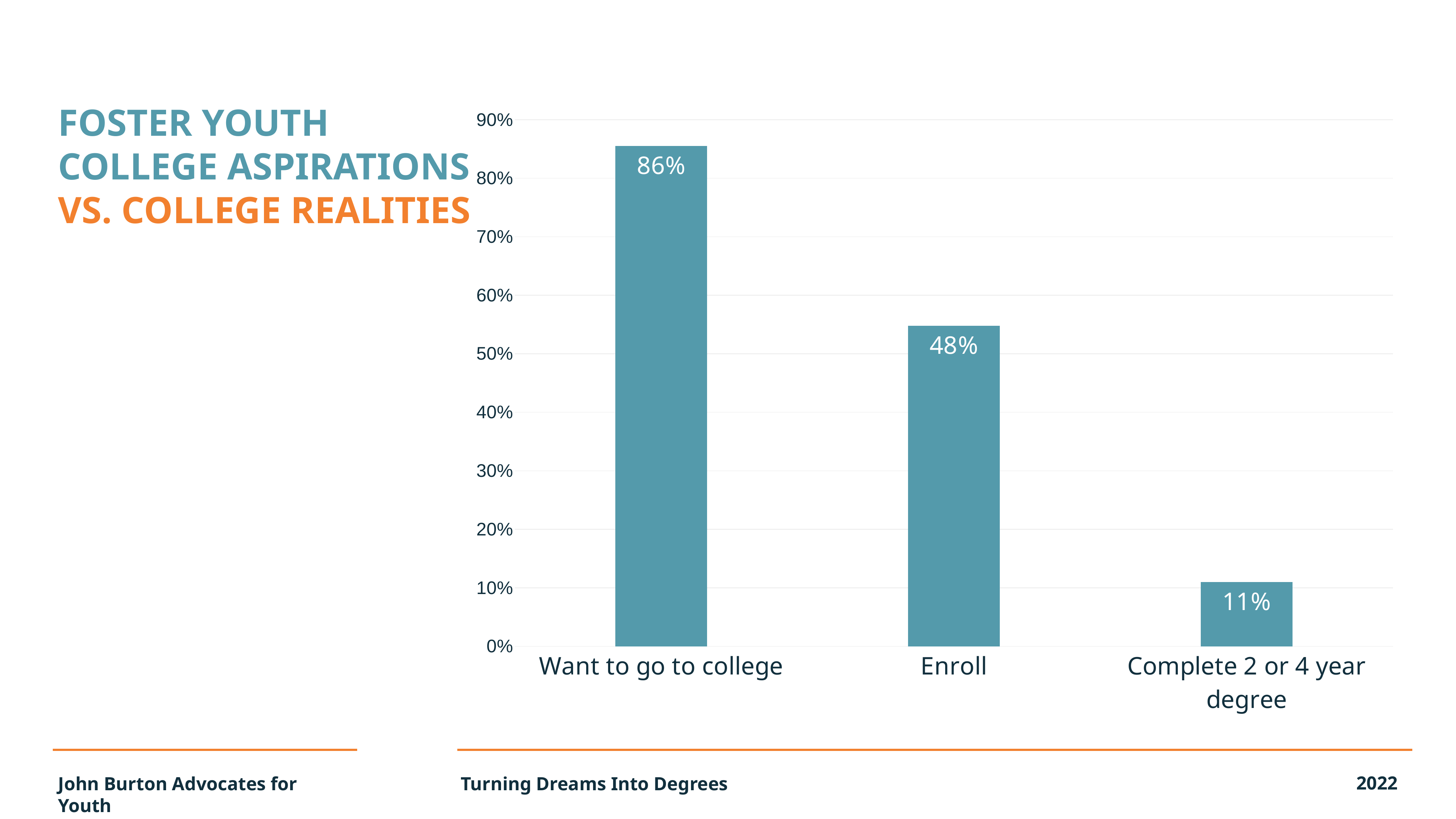
How many categories are shown on the chart? 3 What percentage is shown for Complete 2 or 4 year degree? 11% Which is larger, the value for Enroll or the value for Complete 2 or 4 year degree? Enroll What is the difference between the Enroll value and the Complete 2 or 4 year degree value? 37% Which category has the highest value? Want to go to college What kind of chart is shown on the slide? Bar chart What is the difference between the Want to go to college value and the Enroll value? 38% Which category has the lowest value? Complete 2 or 4 year degree What is the value shown for Enroll? 48% Do the values rise or fall from left to right across the categories? Fall What percentage of foster youth want to go to college? 86%